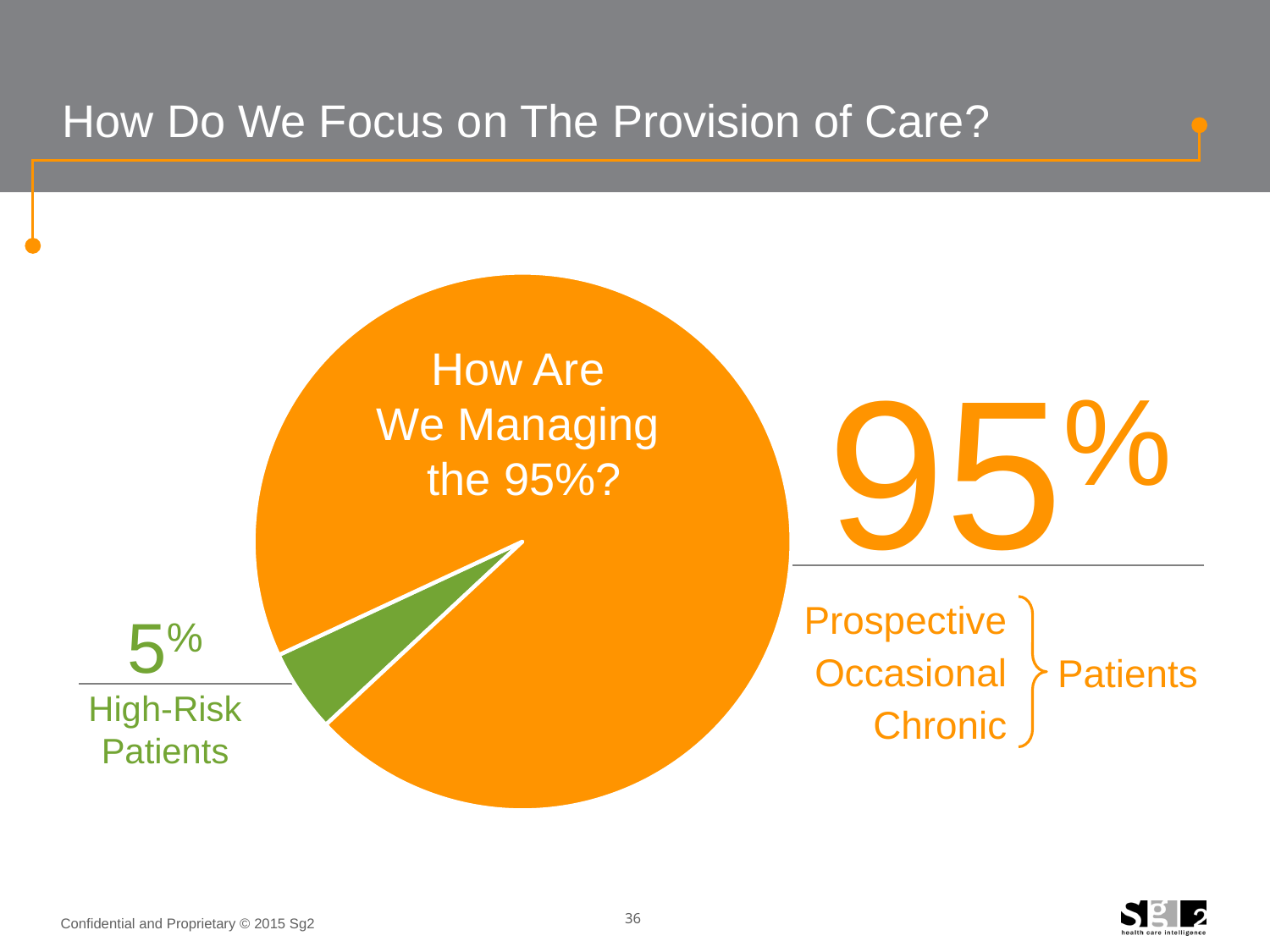
What share of the pie represents Prospective, Occasional and Chronic Patients? 95% What is the total of the two pie slices? 100% How many slices does the pie chart have? 2 What share of the pie is labelled High-Risk Patients? 5% What colour is the High-Risk Patients slice? green What question is written inside the large orange slice of the pie? How Are We Managing the 95%? Which slice of the pie is the largest? Prospective, Occasional, Chronic Patients (95%) What is the difference in percentage points between the 95% slice and the 5% slice? 90 Which is larger: the High-Risk Patients slice or the Prospective/Occasional/Chronic Patients slice? Prospective/Occasional/Chronic Patients Which slice of the pie is the smallest? High-Risk Patients (5%) What kind of chart is shown on the slide? pie chart